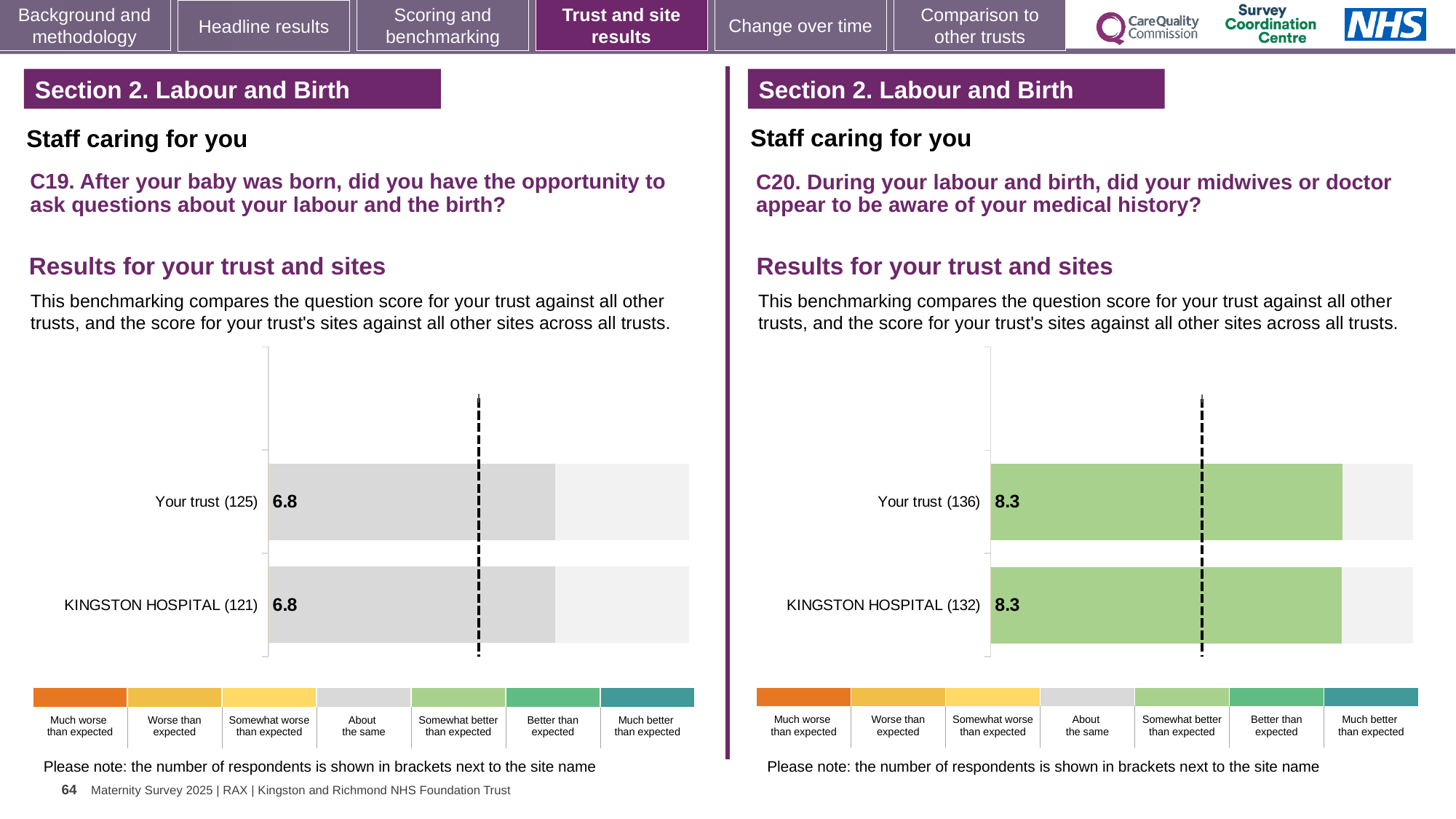
In the C19 chart on the left, what is the score for Your trust (125)? 6.8 How many bars are plotted in the C20 chart on the right? 2 In the C20 chart on the right, what is the score for Your trust (136)? 8.3 How many benchmarking categories are shown in the colour key below the C19 chart on the left? 7 How many respondents are shown in brackets for KINGSTON HOSPITAL in the C20 chart on the right? 132 In the C19 chart on the left, what is the difference between the Your trust score and the KINGSTON HOSPITAL score? 0.0 What type of chart is used for the C19 results on the left? Bar chart How many bars are plotted in the C19 chart on the left? 2 In the C20 chart on the right, what is the score for KINGSTON HOSPITAL (132)? 8.3 In the C19 chart on the left, what is the score for KINGSTON HOSPITAL (121)? 6.8 In the C20 chart on the right, what is the difference between the Your trust score and the KINGSTON HOSPITAL score? 0.0 In the C20 chart on the right, which benchmarking category does the colour of the Your trust bar correspond to? Somewhat better than expected